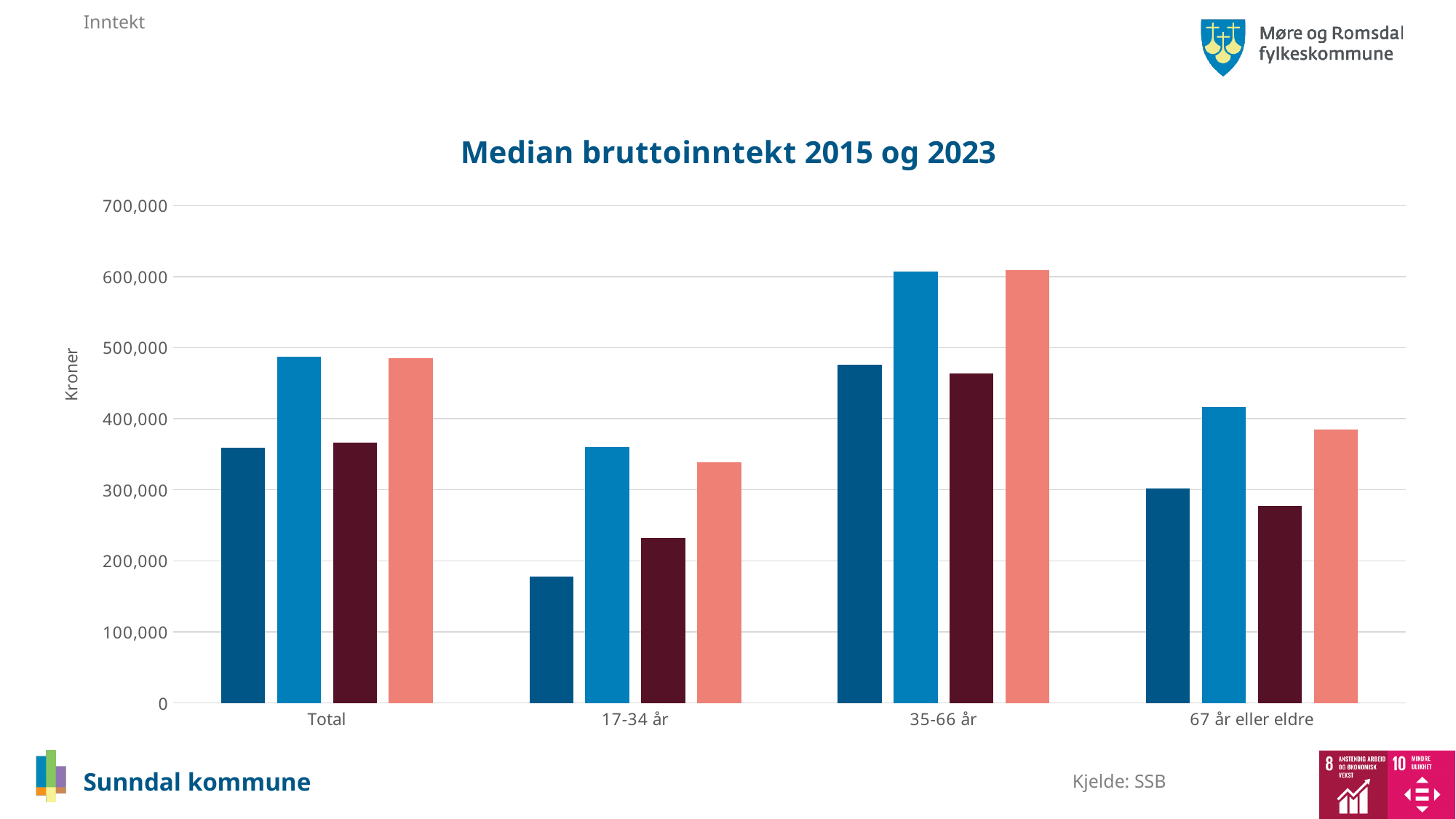
Is the dark blue bar for Total greater or less than 300,000? greater Is the dark red bar for 67 år eller eldre greater or less than 300,000? less Is the salmon-coloured bar for 67 år eller eldre greater or less than 400,000? less Which category has the lowest dark blue bar? 17-34 år For 67 år eller eldre, which is larger: the light blue bar or the salmon-coloured bar? the light blue bar How many categories are shown along the x axis of the chart? 4 Which category has the highest light blue bar? 35-66 år What kind of chart is shown on the slide? bar chart What is the title of the chart? Median bruttoinntekt 2015 og 2023 What is the label on the vertical axis of the chart? Kroner